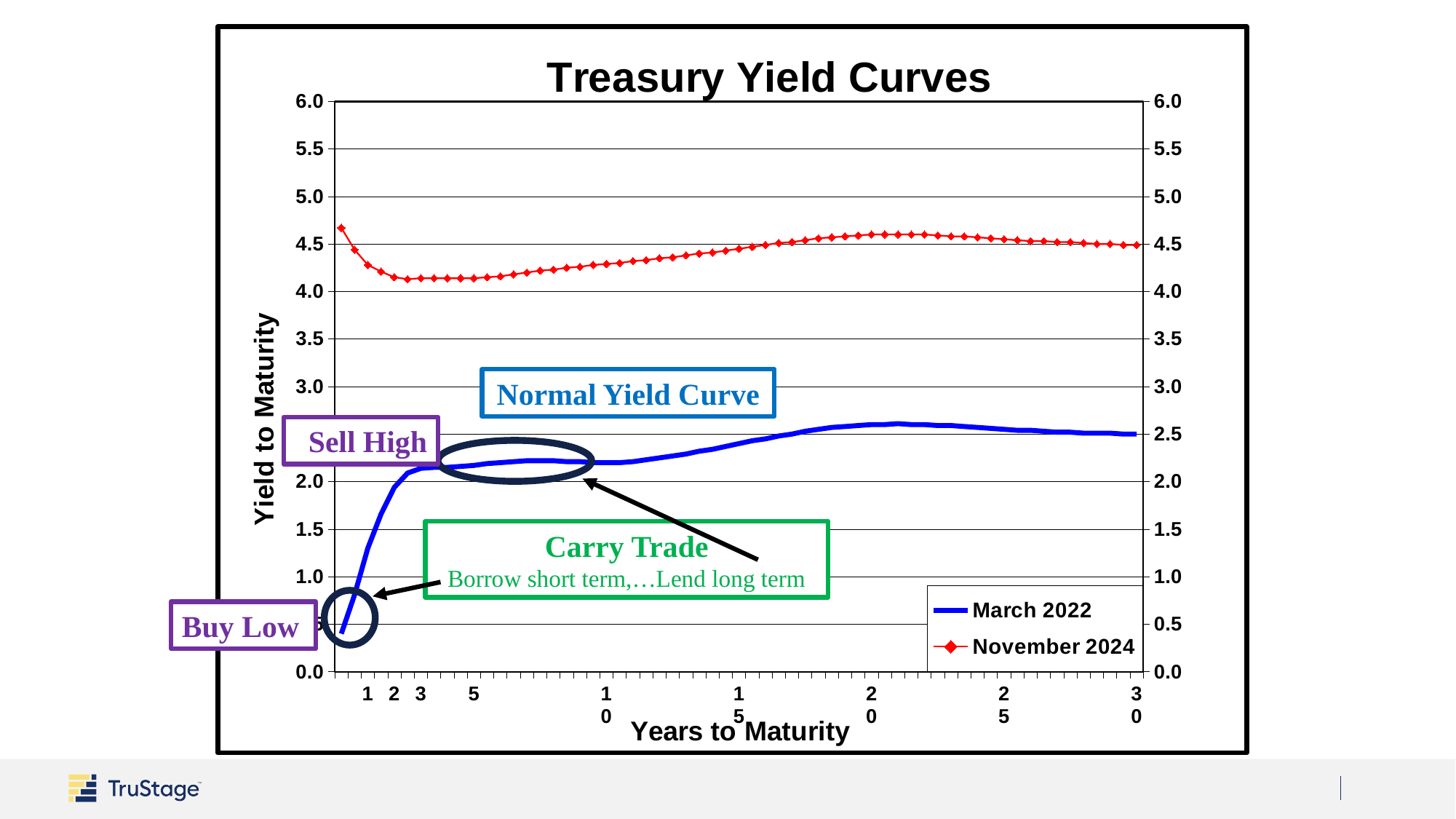
Does the November 2024 yield curve rise or fall between 5 years and 20 years to maturity? rise Is the November 2024 yield at 5 years to maturity greater or less than 4.0? greater Is the March 2022 yield at 20 years to maturity greater or less than 2.0? greater Is the November 2024 yield at 5 years to maturity greater or less than 4.5? less At 10 years to maturity, which series has the higher yield, March 2022 or November 2024? November 2024 What kind of chart is shown on the slide? line chart What is the title of the chart? Treasury Yield Curves Which series is drawn in blue according to the legend? March 2022 How many series does the legend list? 2 Does the March 2022 yield curve rise or fall between 1 year and 5 years to maturity? rise